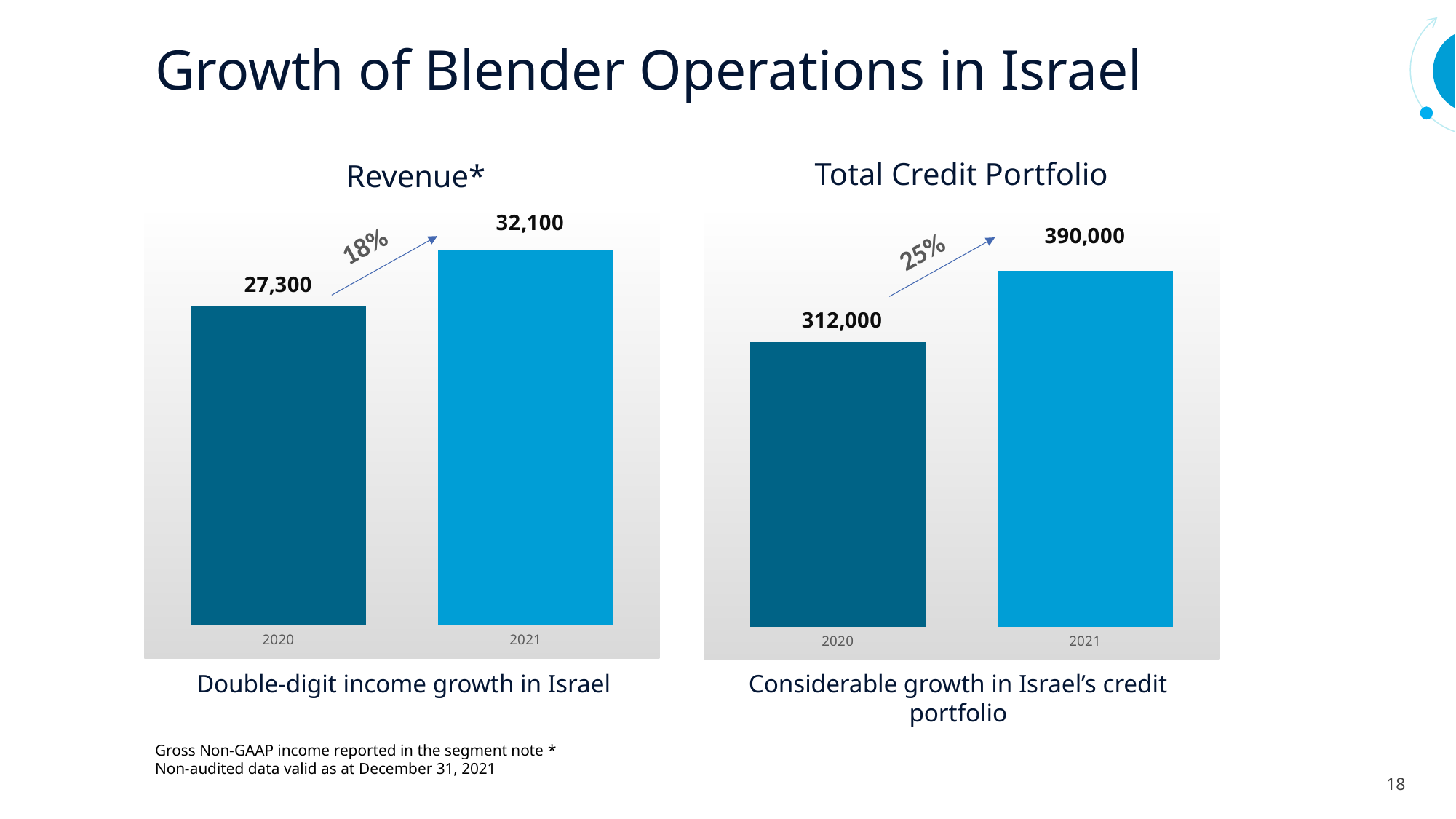
In the Revenue* chart, how many years are shown on the x axis? 2 In the Revenue* chart, what percentage growth is shown between 2020 and 2021? 18% What kind of chart is the Total Credit Portfolio chart? Bar chart In the Total Credit Portfolio chart, what is the difference between the 2021 and 2020 values? 78,000 In the Total Credit Portfolio chart, what is the value for 2021? 390,000 In the Revenue* chart, which year has the higher value? 2021 In the Revenue* chart, what is the value for 2021? 32,100 In the Total Credit Portfolio chart, what percentage growth is shown between 2020 and 2021? 25% In the Total Credit Portfolio chart, what is the value for 2020? 312,000 In the Revenue* chart, what is the difference between the 2021 and 2020 values? 4,800 In the Revenue* chart, what is the value for 2020? 27,300 In the Total Credit Portfolio chart, which year has the lower value? 2020